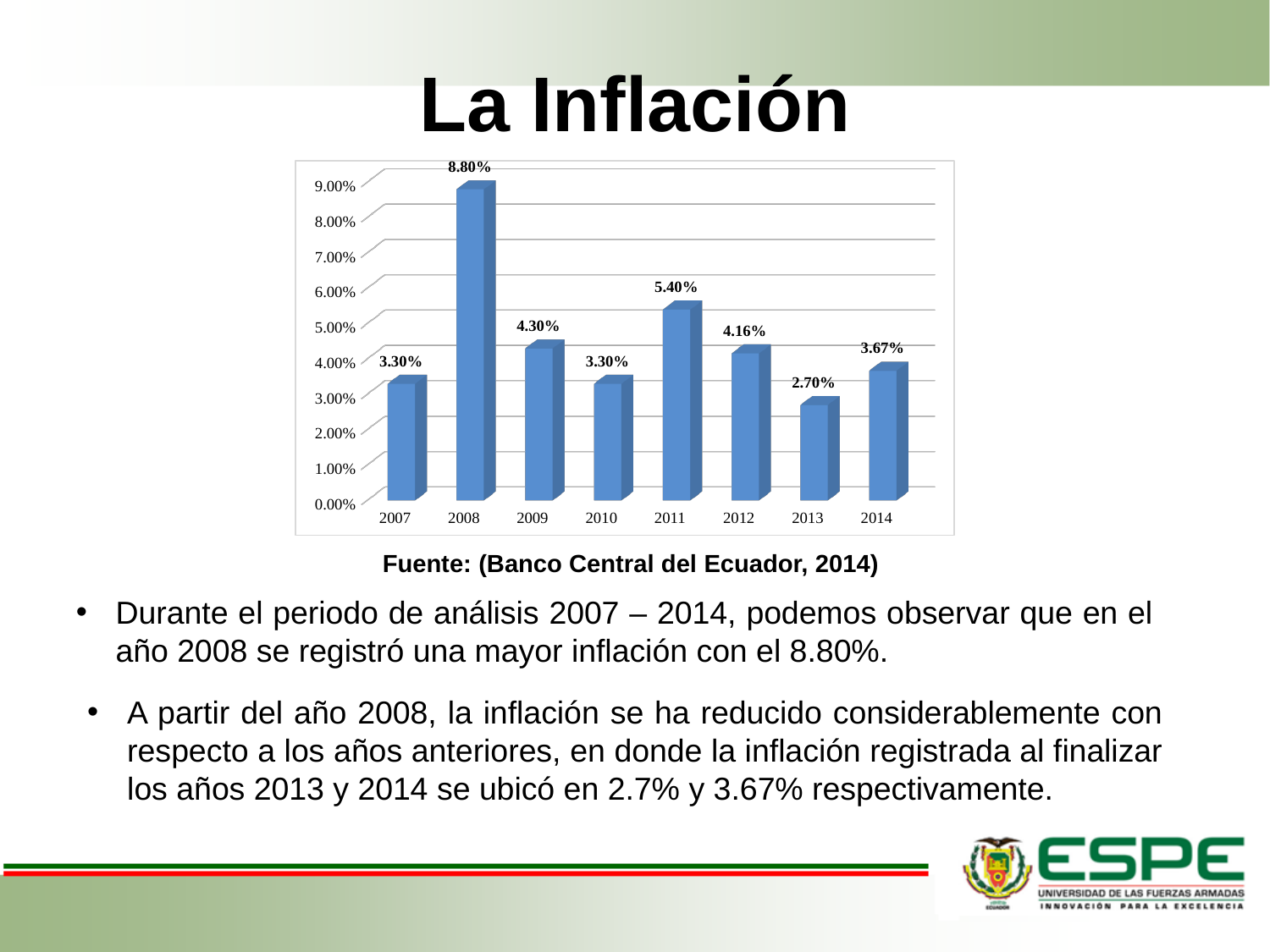
What is the inflation value shown for 2013? 2.70% Which year has the highest inflation value? 2008 How many years are shown on the x axis of the chart? 8 Which year has the lowest inflation value? 2013 Does the inflation value rise or fall from 2011 to 2013? Fall What kind of chart is shown on the slide? Bar chart What is the inflation value shown for 2014? 3.67% What is the difference between the inflation values for 2014 and 2013? 0.97% What is the inflation value shown for 2011? 5.40% What is the difference between the inflation values for 2008 and 2009? 4.50% Which year has a larger inflation value, 2011 or 2012? 2011 What is the inflation value shown for 2008? 8.80%